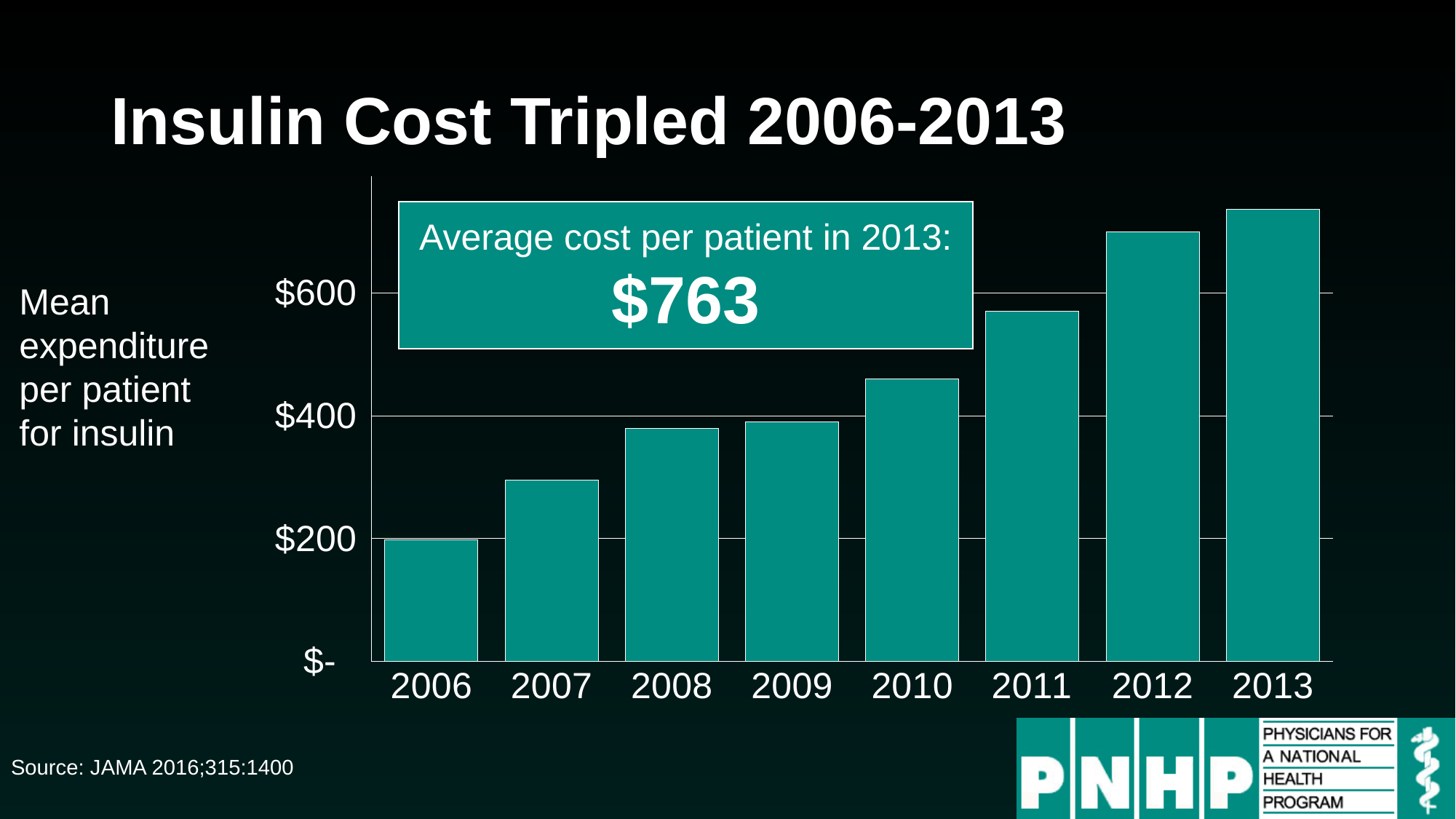
What is the title of the slide? Insulin Cost Tripled 2006-2013 What was the average cost per patient for insulin in 2013? $763 Which year has the lowest mean expenditure per patient for insulin? 2006 Is the value for 2010 greater or less than $400? greater Is the value for 2007 greater or less than $400? less Do the values rise or fall from 2006 to 2013? rise What kind of chart is shown on the slide? bar chart How many years are plotted on the chart? 8 Is the value for 2012 greater or less than $600? greater Which year has a larger value, 2008 or 2012? 2012 Which year has the highest mean expenditure per patient for insulin? 2013